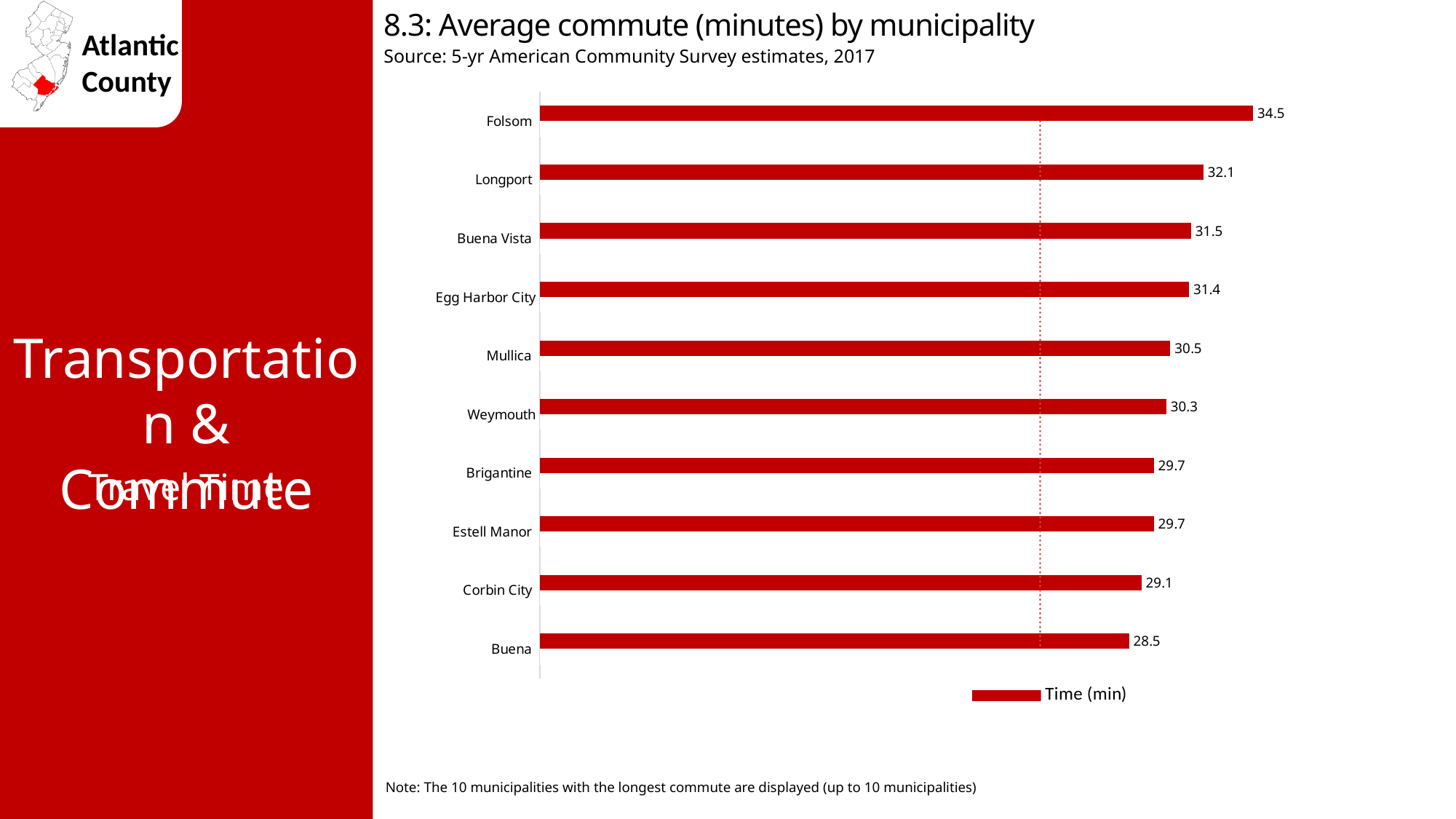
How many municipalities are shown in the chart? 10 What is the difference in average commute time between Longport and Buena Vista? 0.6 What is the average commute time for Corbin City? 29.1 What is the legend entry for the series in the chart? Time (min) Which municipality shown has the shortest average commute? Buena How many series does the legend list? 1 What is the average commute time for Folsom? 34.5 What is the difference in average commute time between Folsom and Buena? 6.0 What is the average commute time for Mullica? 30.5 Which municipality has the longest average commute? Folsom What kind of chart is shown on the slide? Bar chart Which has a longer average commute, Egg Harbor City or Weymouth? Egg Harbor City